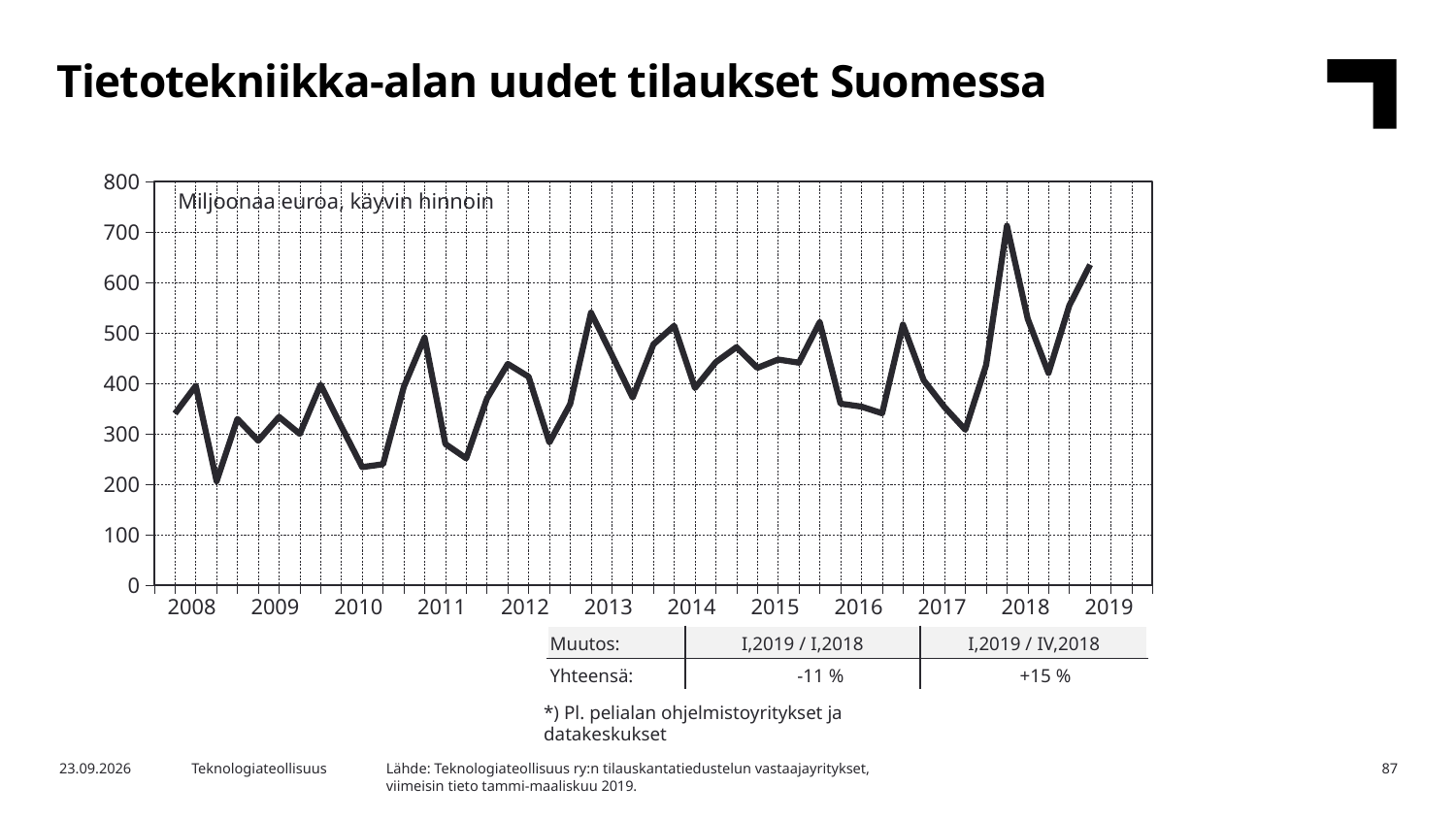
Is the first plotted value, in 2008, greater or less than 400? less According to the table below the chart, what is the change for I,2019 / I,2018? -11 % In what unit are the values on the chart expressed, according to the label inside the plot area? Miljoonaa euroa, käyvin hinnoin In which year does the line reach its lowest point? 2008 Is the last plotted value, in 2019, greater or less than 500? greater What is the title of the chart? Tietotekniikka-alan uudet tilaukset Suomessa Is the highest point of the line, in 2018, greater or less than 600? greater In which year does the line reach its highest point? 2018 How many years are labelled on the x axis? 12 Overall, do the values rise or fall from 2008 to 2019? rise What kind of chart is shown on the slide? line chart